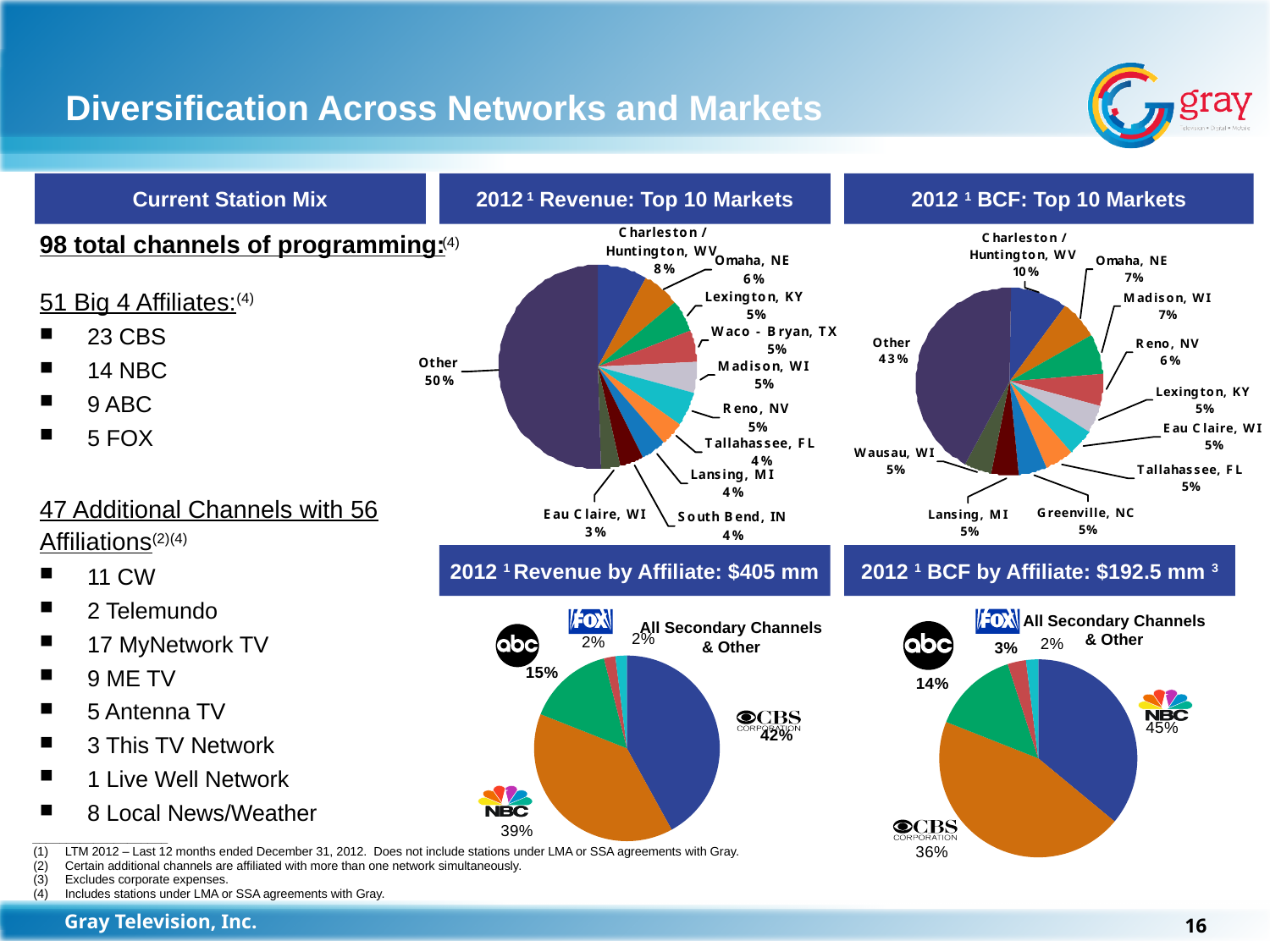
In the '2012 Revenue: Top 10 Markets' chart, which named market (excluding 'Other') has the smallest share? Eau Claire, WI In the '2012 BCF by Affiliate: $192.5 mm' chart, which affiliate has the largest share? NBC In the '2012 BCF by Affiliate: $192.5 mm' chart, what share does ABC have? 14% In the '2012 Revenue: Top 10 Markets' chart, what share does Charleston / Huntington, WV have? 8% What type of chart is used for '2012 Revenue by Affiliate: $405 mm'? Pie chart In the '2012 BCF: Top 10 Markets' chart, what share does Charleston / Huntington, WV have? 10% In the '2012 Revenue by Affiliate: $405 mm' chart, what share does NBC have? 39% In the '2012 BCF: Top 10 Markets' chart, what share is labelled 'Other'? 43% In the '2012 Revenue: Top 10 Markets' chart, what share is labelled 'Other'? 50% In the '2012 BCF by Affiliate: $192.5 mm' chart, which is larger, the CBS share or the NBC share? NBC In the '2012 Revenue by Affiliate: $405 mm' chart, what share does CBS have? 42% In the '2012 BCF: Top 10 Markets' chart, what is the difference between the Charleston / Huntington, WV share and the Reno, NV share? 4%